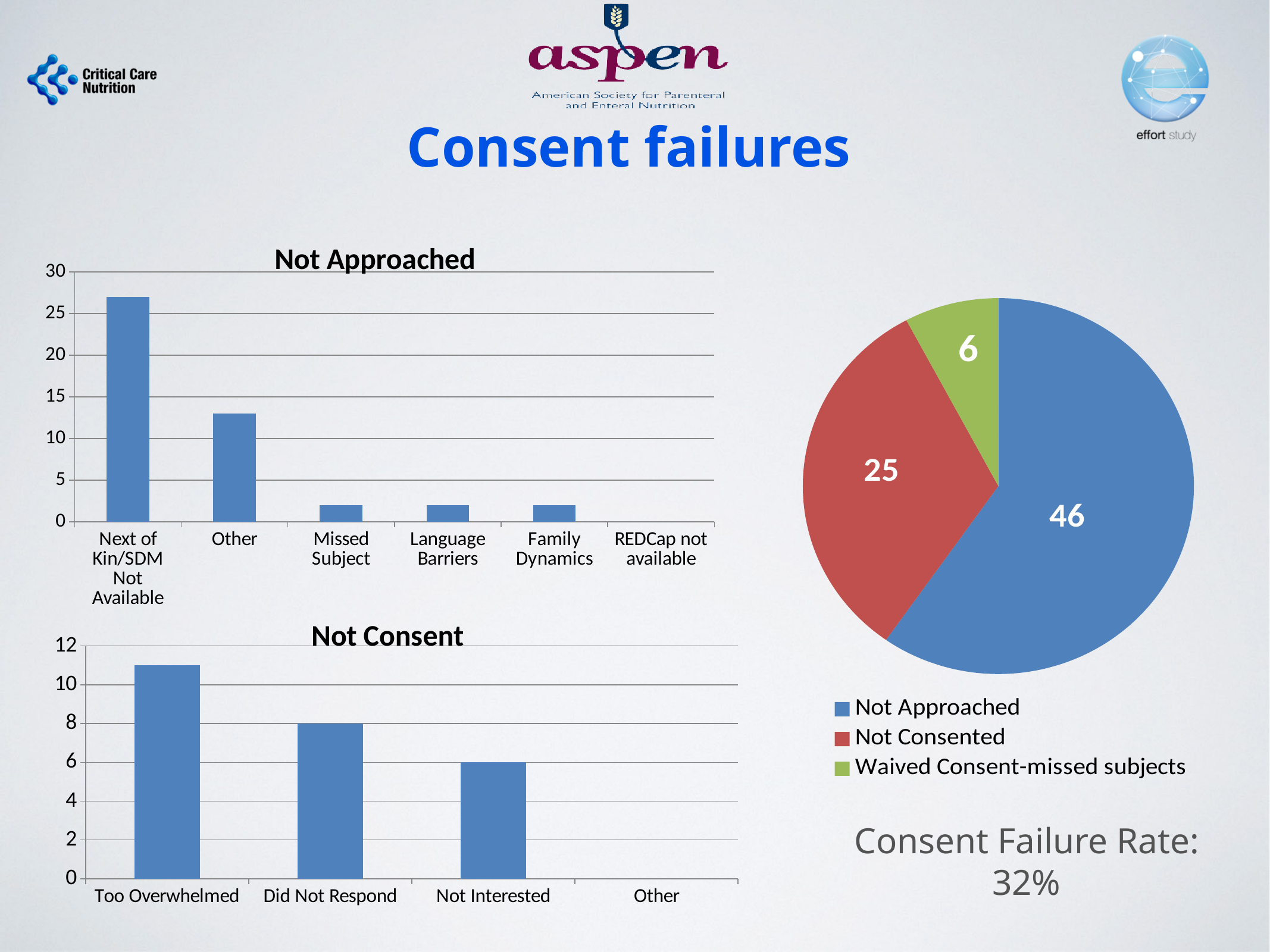
In the Not Approached chart, which category has the highest value? Next of Kin/SDM Not Available In the Not Approached chart, is the value for Other greater or less than 10? greater How many categories are shown on the x axis of the Not Approached chart? 6 In the pie chart, what is the value for Waived Consent-missed subjects? 6 In the Not Consent chart, what is the value for Not Interested? 6 In the Not Consent chart, is the value for Too Overwhelmed greater or less than 10? greater In the Not Consent chart, which category has the highest value? Too Overwhelmed In the pie chart, what is the value for Not Approached? 46 In the pie chart, what is the difference between the Not Approached and Not Consented values? 21 How many entries does the legend of the pie chart list? 3 In the Not Consent chart, what is the value for Did Not Respond? 8 In the pie chart, what is the total of all three slices? 77